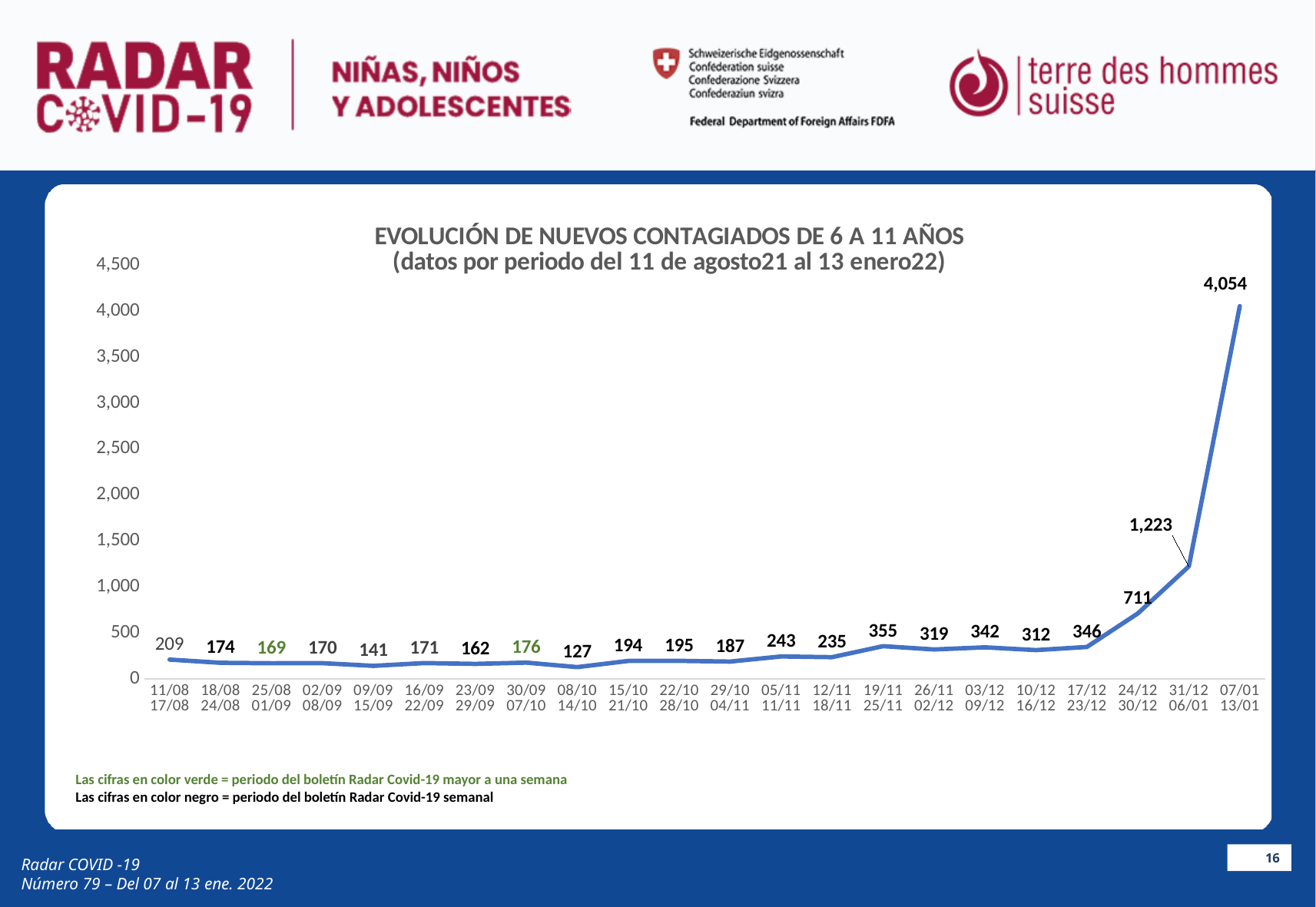
What type of chart is shown on the slide? line chart Do the values generally rise or fall from 17/12–23/12 to 07/01–13/01? rise Which is larger, the value for 24/12–30/12 or the value for 17/12–23/12? 24/12–30/12 Which period has the highest value? 07/01–13/01 What is the value for the period 08/10–14/10? 127 How many periods (data points) are plotted on the chart? 22 What is the difference between the values for 07/01–13/01 and 31/12–06/01? 2,831 According to the note below the chart, what do the green figures indicate? periodo del boletín Radar Covid-19 mayor a una semana What is the value for the period 07/01–13/01? 4,054 Which period has the lowest value? 08/10–14/10 What is the value for the period 19/11–25/11? 355 What is the value for the period 31/12–06/01? 1,223